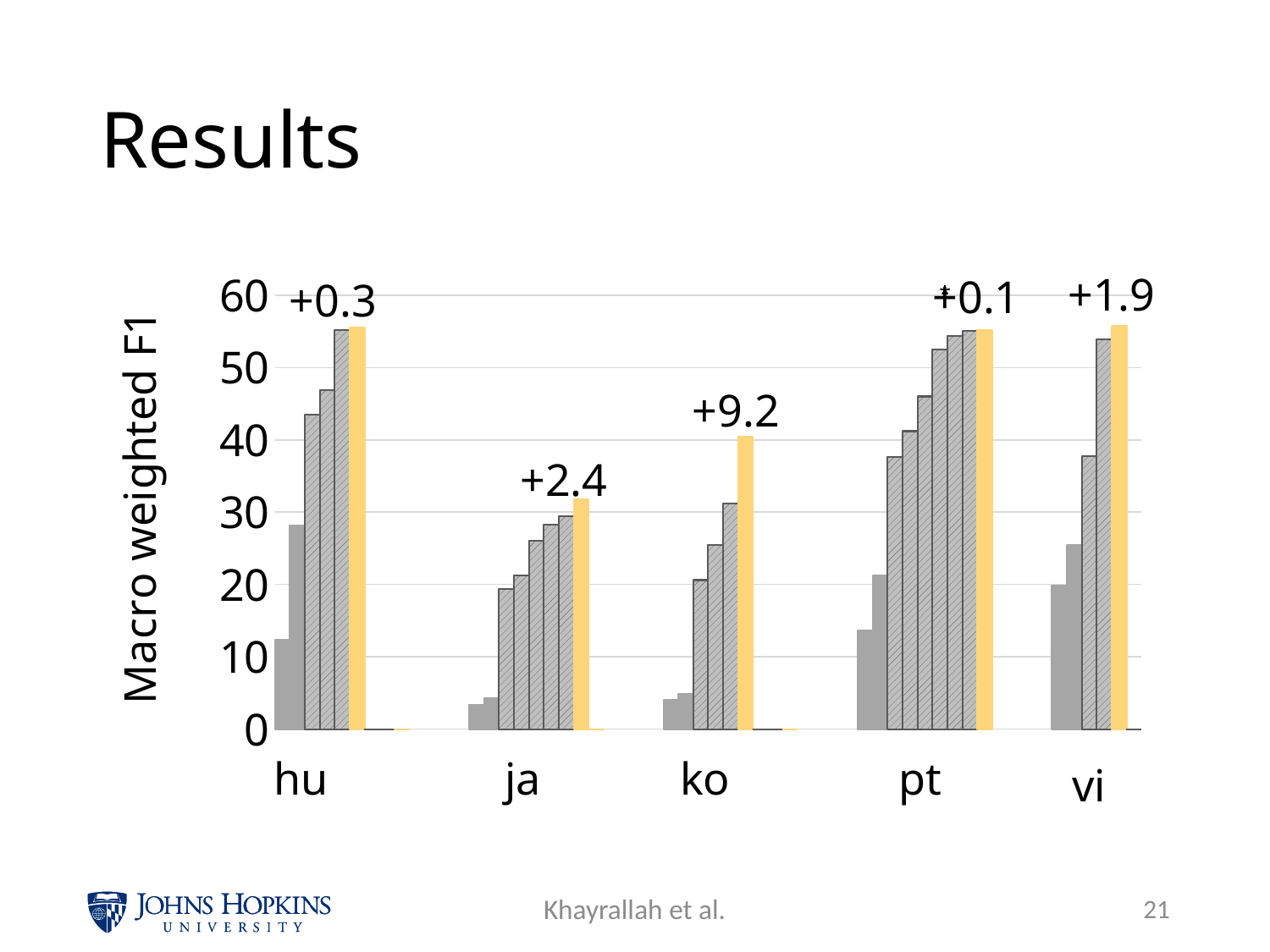
Which language group has the largest annotated improvement? ko What is the difference between the annotated improvements for ko and ja? 6.8 What improvement value is annotated above the vi group? +1.9 Which language group has the smallest annotated improvement? pt What is the y-axis label of the chart? Macro weighted F1 What improvement value is annotated above the ko group? +9.2 What kind of chart is shown on the slide? bar chart What improvement value is annotated above the ja group? +2.4 Which is taller, the yellow bar for ko or the yellow bar for ja? ko Is the yellow bar for hu greater or less than 50? greater How many language categories are shown on the x axis? 5 Is the yellow bar for ja greater or less than 30? greater